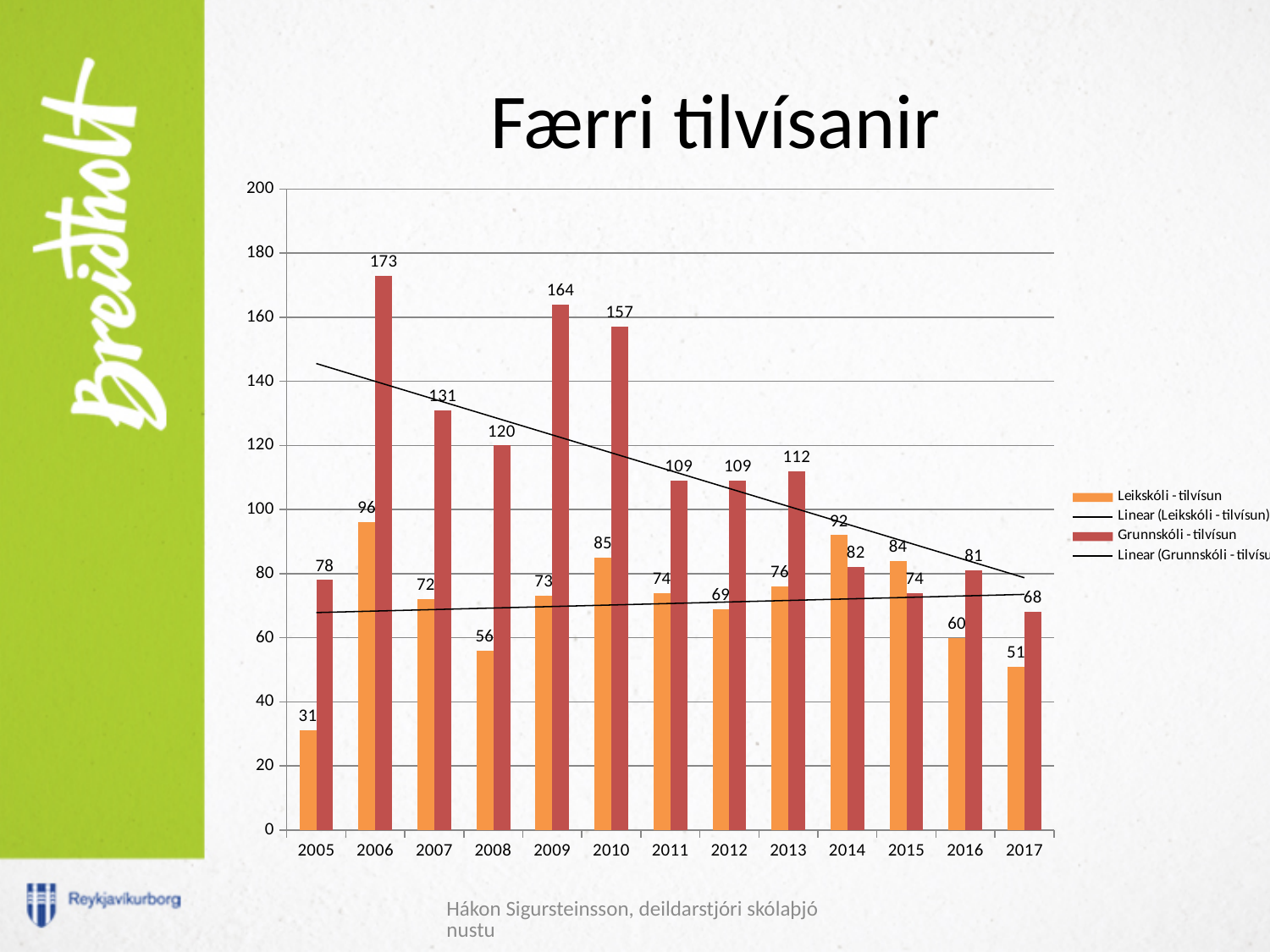
What is the Grunnskóli - tilvísun value for 2006? 173 What is the Grunnskóli - tilvísun value for 2017? 68 How many years are shown on the x axis? 13 What is the title of the chart? Færri tilvísanir What kind of chart is shown on the slide? Bar chart In which year is the Grunnskóli - tilvísun value highest? 2006 Which is larger in 2015: the Leikskóli - tilvísun value or the Grunnskóli - tilvísun value? Leikskóli - tilvísun Does the Grunnskóli - tilvísun value rise or fall from 2013 to 2017? Fall What is the difference between the Grunnskóli - tilvísun and Leikskóli - tilvísun values in 2009? 91 How many entries does the legend list? 4 In which year is the Leikskóli - tilvísun value lowest? 2005 What is the Leikskóli - tilvísun value for 2014? 92